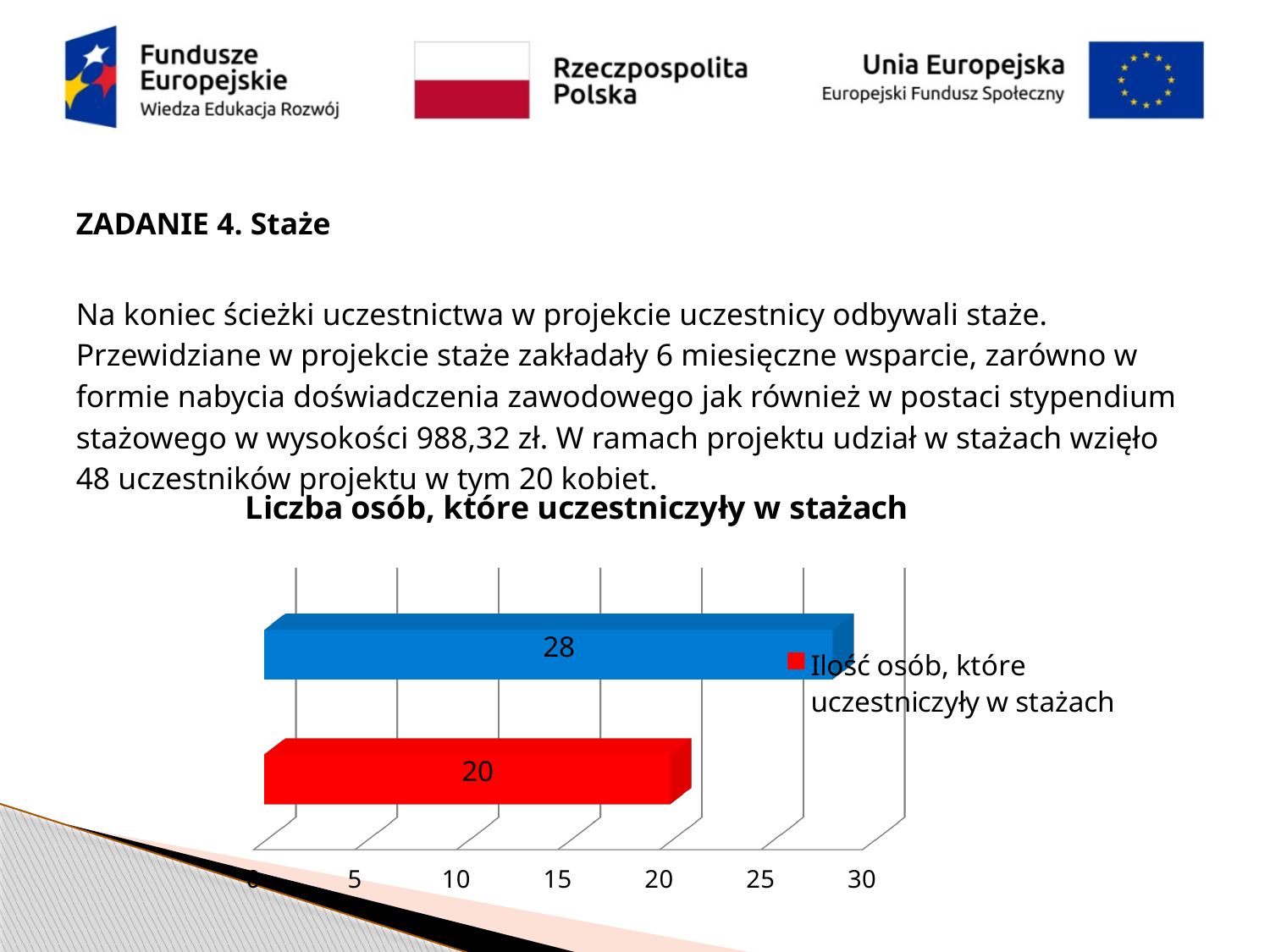
What value is shown on the blue (top) bar of the chart? 28 How many series does the chart legend list? 1 What is the title of the chart? Liczba osób, które uczestniczyły w stażach What is the difference between the values of the blue bar and the red bar? 8 Is the value of the blue bar greater or less than 25? greater Which bar is longer, the blue one or the red one? The blue one What kind of chart is shown on the slide? Bar chart How many bars are plotted in the chart? 2 Which bar in the chart has the highest value? The blue (top) bar Which bar in the chart has the lowest value? The red (bottom) bar What value is shown on the red (bottom) bar of the chart? 20 What is the legend entry of the chart? Ilość osób, które uczestniczyły w stażach